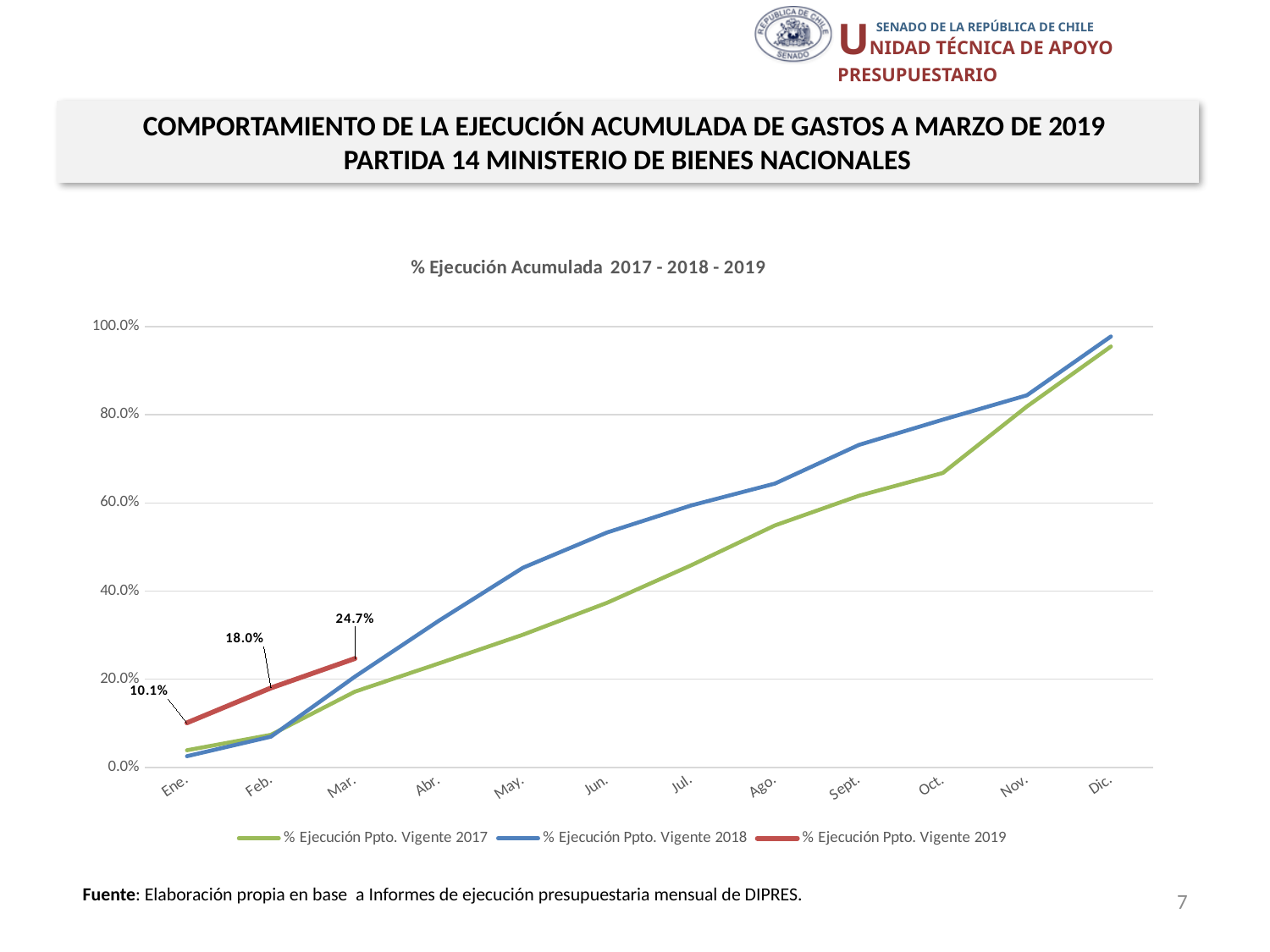
Is the value for Mar. in the % Ejecución Ppto. Vigente 2017 series greater or less than 20.0%? less How many series does the legend list? 3 How many months are shown on the x axis? 12 Does the % Ejecución Ppto. Vigente 2019 series rise or fall from Ene. to Mar.? Rise What is the value for Feb. in the % Ejecución Ppto. Vigente 2019 series? 18.0% What is the value for Mar. in the % Ejecución Ppto. Vigente 2019 series? 24.7% What is the difference between the Mar. and Feb. values of the % Ejecución Ppto. Vigente 2019 series? 6.7% What is the value for Ene. in the % Ejecución Ppto. Vigente 2019 series? 10.1% What kind of chart is shown on the slide? Line chart Is the value for Dic. in the % Ejecución Ppto. Vigente 2018 series greater or less than 80.0%? greater In Oct., which series has the larger value: % Ejecución Ppto. Vigente 2017 or % Ejecución Ppto. Vigente 2018? % Ejecución Ppto. Vigente 2018 Which month has the highest value in the % Ejecución Ppto. Vigente 2019 series? Mar.